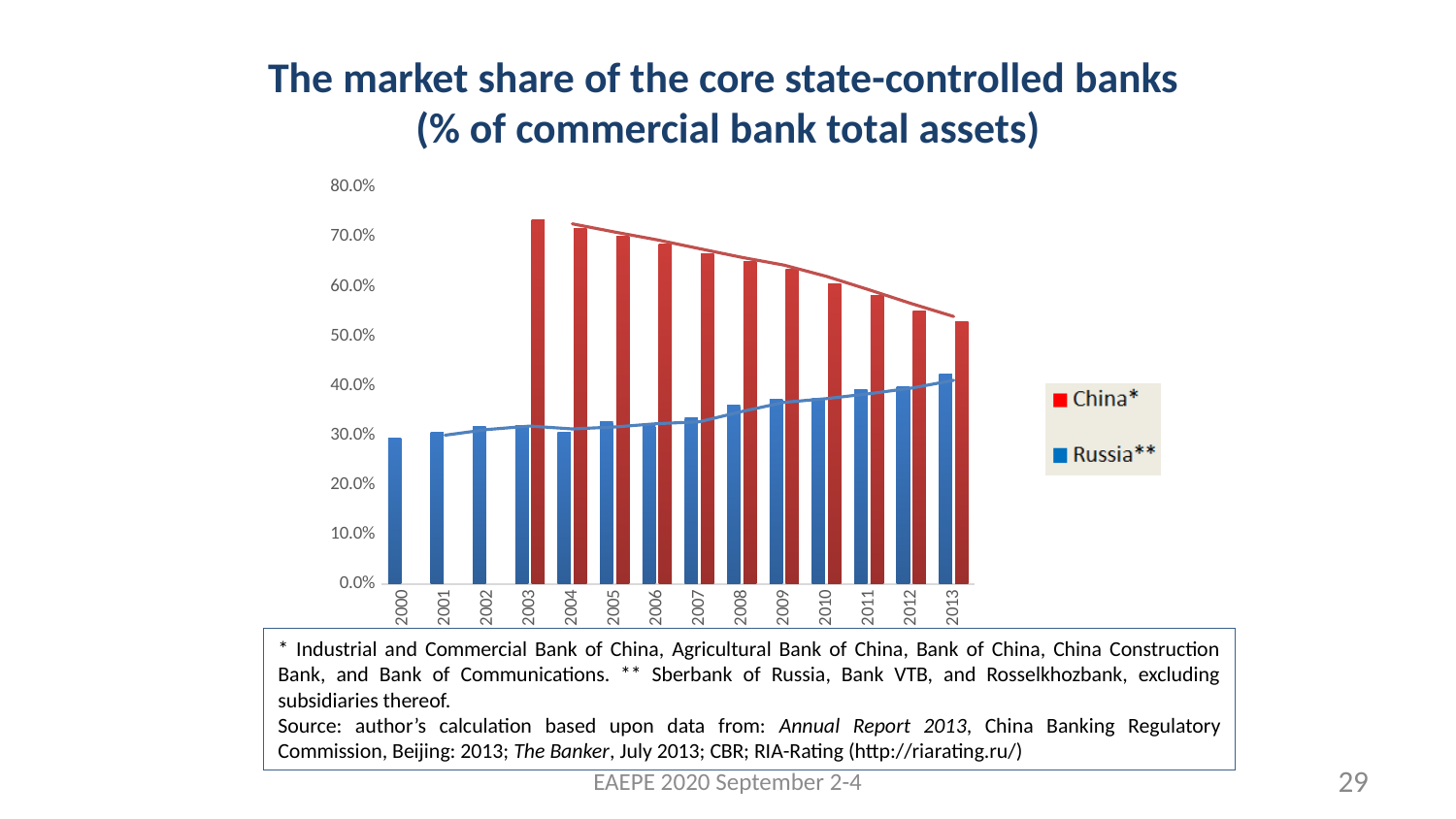
Do the values for Russia** rise or fall from 2000 to 2013? rise What kind of chart is shown on the slide? bar chart Is the value for China* in 2003 greater or less than 70.0%? greater How many years are shown on the x axis? 14 In which year is the value for China* lowest? 2013 Is the value for Russia** in 2013 greater or less than 40.0%? greater In which year is the value for China* highest? 2003 In which year is the value for Russia** highest? 2013 Do the values for China* rise or fall from 2003 to 2013? fall How many series does the legend list? 2 Which is larger in 2005, the value for China* or the value for Russia**? China* Which series is shown in red? China*